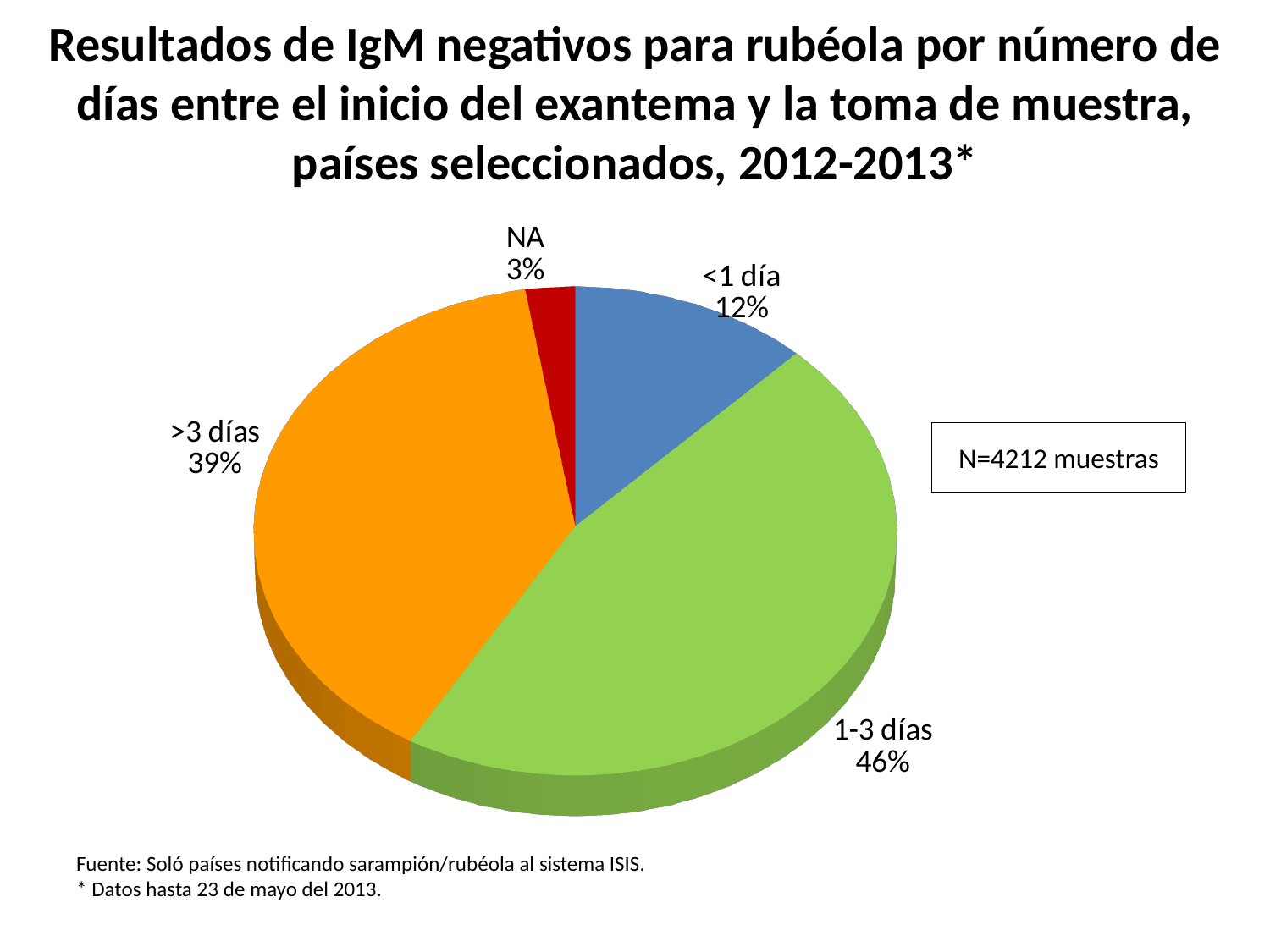
How many slices does the pie chart have? 4 What is the value shown for the "<1 día" slice? 12% What share of the pie does the "1-3 días" slice represent? 46% What kind of chart is shown on the slide? Pie chart Which category has the smallest slice of the pie? NA What is the difference in percentage points between the "1-3 días" and ">3 días" slices? 7 Which category has the largest slice of the pie? 1-3 días What share of the pie does the ">3 días" slice represent? 39% What is the total number of samples (N) stated on the slide? N=4212 muestras What is the value shown for the "NA" slice? 3% Which is larger, the "<1 día" slice or the "NA" slice? <1 día What colour is the ">3 días" slice? Orange